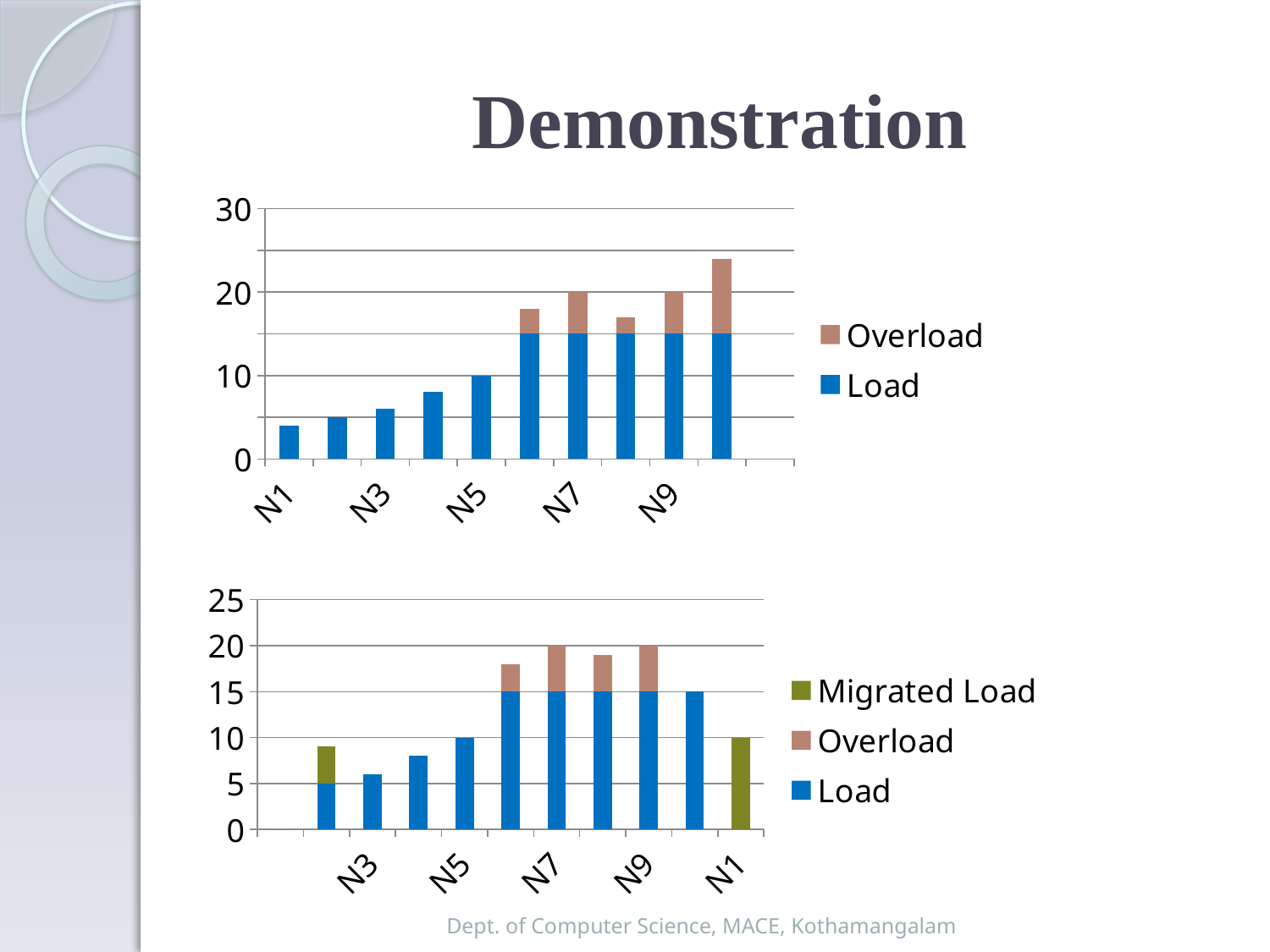
What kind of chart is the top chart on the slide? Stacked bar chart How many series does the legend of the bottom chart list? 3 In the bottom chart, what is the total height of the stacked bar for N7? 20 How many series does the legend of the top chart list? 2 In the bottom chart, is the value for N3 greater or less than 10? less In the bottom chart, what is the Load value for N5? 10 In the top chart, is the value for N1 greater or less than 10? less In the top chart, is the total for N7 greater or less than 15? greater In the top chart, which is larger, the value for N1 or the value for N5? N5 In the top chart, what is the Load value for N5? 10 In the top chart, do the bar heights generally rise or fall from N1 to N9? rise What are the legend entries of the bottom chart? Migrated Load, Overload, Load